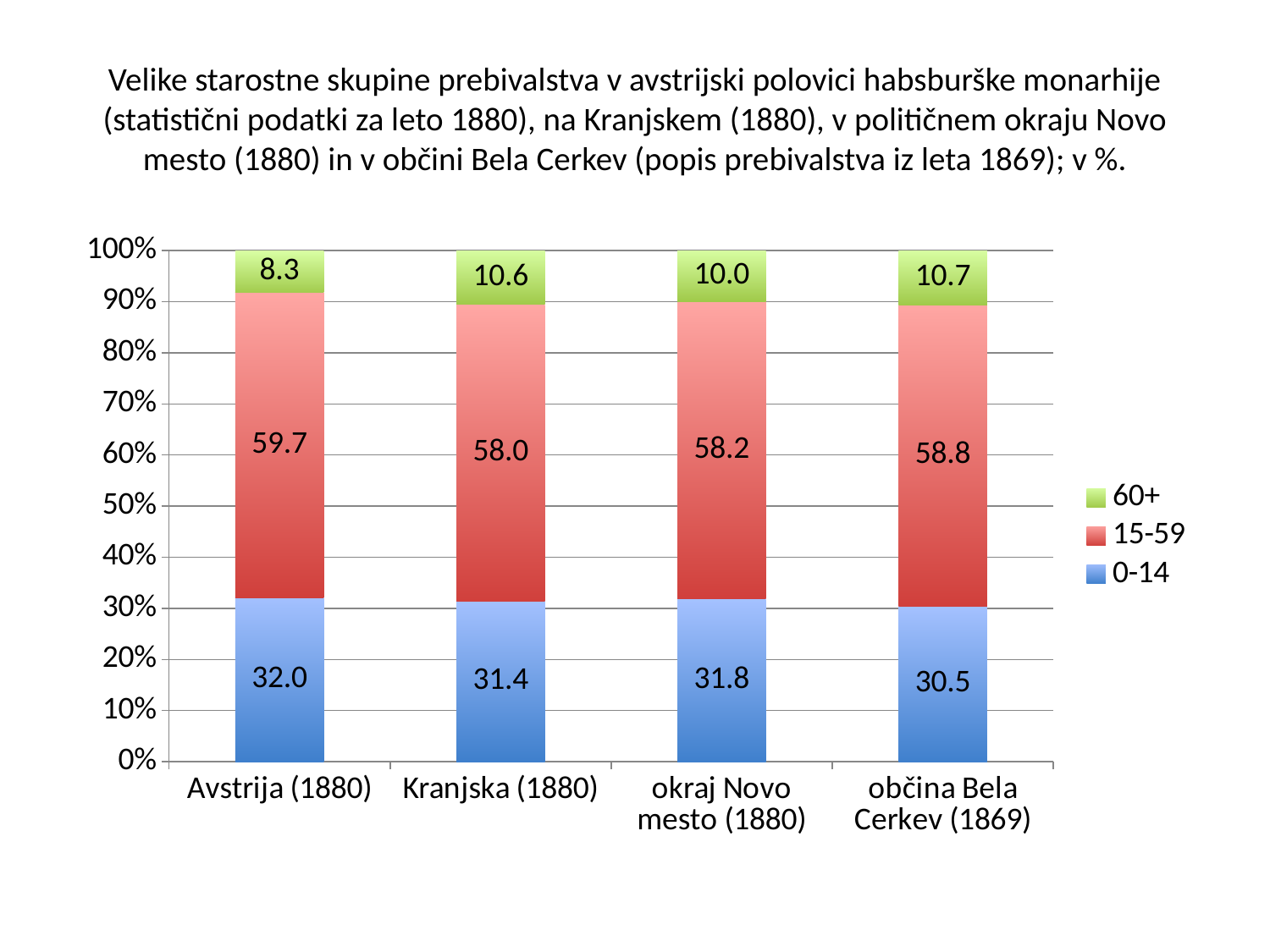
What is the value for the 60+ series for okraj Novo mesto (1880)? 10.0 What is the difference between the 60+ values for občina Bela Cerkev (1869) and Avstrija (1880)? 2.4 What is the value for the 60+ series for Avstrija (1880)? 8.3 What is the value for the 15-59 series for Kranjska (1880)? 58.0 What is the value for the 0-14 series for občina Bela Cerkev (1869)? 30.5 How many series does the legend list? 3 Which is larger, the 0-14 value for Avstrija (1880) or for Kranjska (1880)? Avstrija (1880) How many categories are shown on the x axis? 4 Which category has the highest value for the 15-59 series? Avstrija (1880) Which category has the lowest value for the 0-14 series? občina Bela Cerkev (1869) Which category has the lowest value for the 60+ series? Avstrija (1880) What kind of chart is shown on the slide? Stacked bar chart